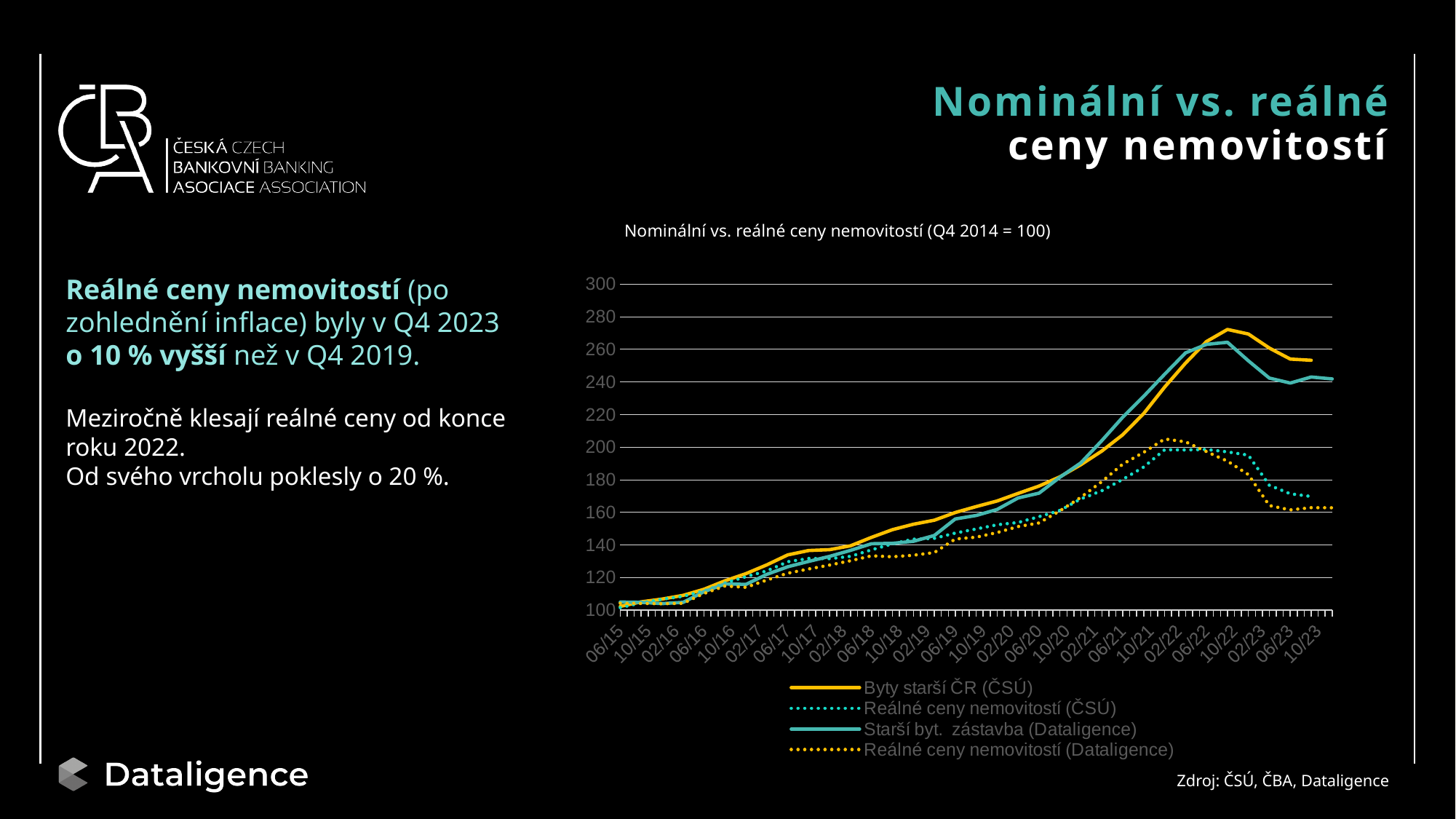
Is the value of Reálné ceny nemovitostí (Dataligence) at 10/23 greater or less than 180? less Which series is drawn as a solid yellow line according to the legend? Byty starší ČR (ČSÚ) Is the value of Starší byt. zástavba (Dataligence) at 10/23 greater or less than 220? greater How many series does the chart legend list? 4 Does the Reálné ceny nemovitostí (Dataligence) series rise or fall between 02/22 and 10/23? Fall What is the title of the chart? Nominální vs. reálné ceny nemovitostí (Q4 2014 = 100) At 10/23, which is larger: Byty starší ČR (ČSÚ) or Starší byt. zástavba (Dataligence)? Byty starší ČR (ČSÚ) Is the value of Byty starší ČR (ČSÚ) at 10/22 greater or less than 260? greater Does the Byty starší ČR (ČSÚ) series rise or fall between 06/15 and 02/22? Rise What kind of chart is shown on the slide? Line chart Which series reaches the highest value anywhere on the chart? Byty starší ČR (ČSÚ)